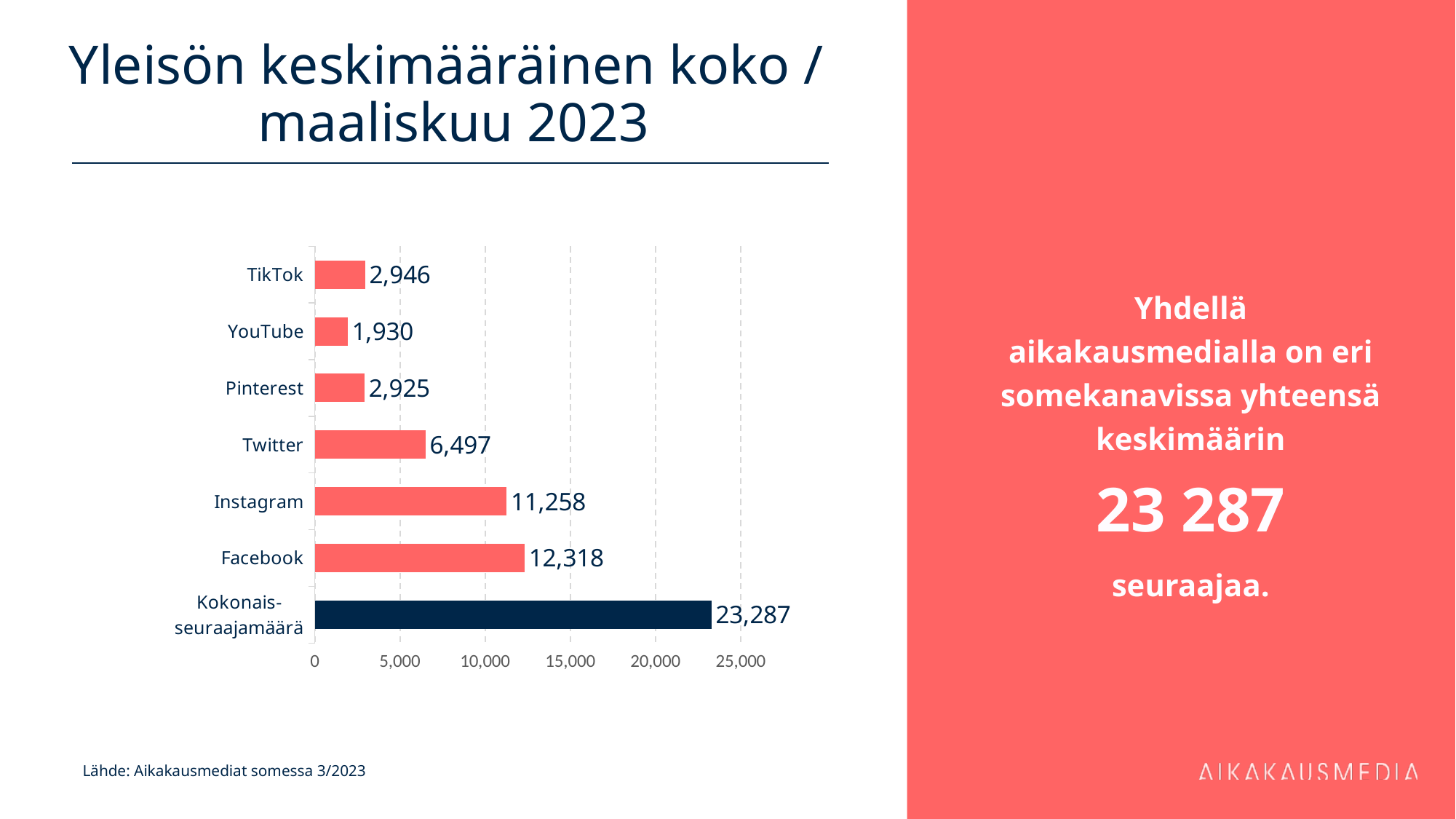
What is the value for Twitter? 6,497 Which individual platform (excluding the total bar) has the highest value? Facebook How many bars are shown in the chart? 7 What is the value for Facebook? 12,318 What is the difference between the values for Facebook and Instagram? 1,060 What is the value for Kokonais-seuraajamäärä? 23,287 Which category has the highest value? Kokonais-seuraajamäärä Which category has the lowest value? YouTube Is the value for Twitter greater or less than 5,000? greater What is the difference between the values for Twitter and Pinterest? 3,572 Which is larger, the value for Instagram or the value for Twitter? Instagram What is the value for YouTube? 1,930